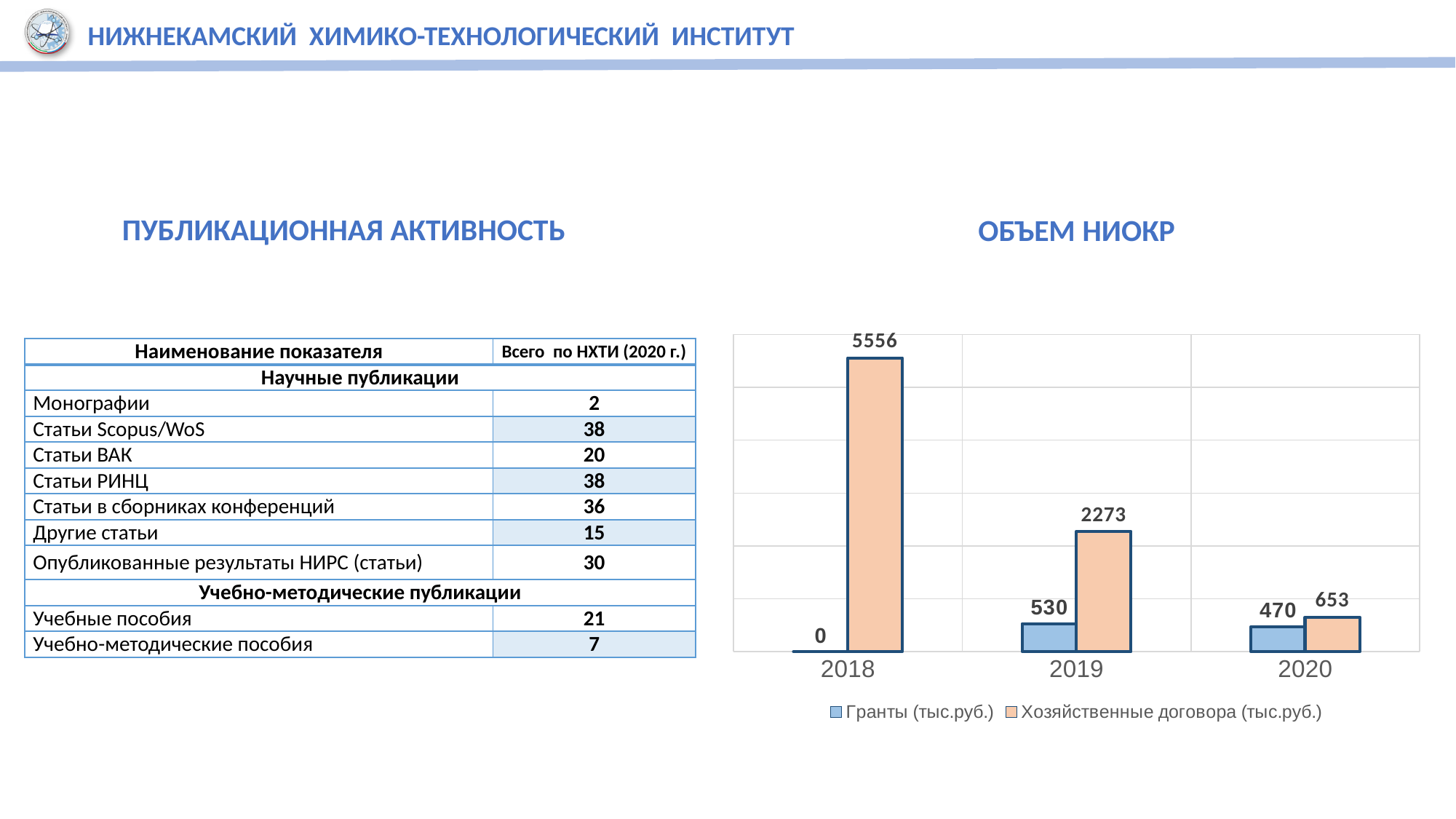
In which year is the value of Хозяйственные договора (тыс.руб.) highest? 2018 What type of chart is shown under the heading ОБЪЕМ НИОКР? bar chart How many years are shown on the x axis of the chart? 3 Which is larger in 2020: Гранты (тыс.руб.) or Хозяйственные договора (тыс.руб.)? Хозяйственные договора (тыс.руб.) How many series does the chart legend list? 2 What is the value of Хозяйственные договора (тыс.руб.) for 2018? 5556 What is the difference between Хозяйственные договора (тыс.руб.) in 2018 and 2019? 3283 What is the value of Хозяйственные договора (тыс.руб.) for 2020? 653 In which year is the value of Гранты (тыс.руб.) lowest? 2018 Does the value of Хозяйственные договора (тыс.руб.) rise or fall from 2018 to 2020? fall What is the value of Гранты (тыс.руб.) for 2019? 530 What is the value of Гранты (тыс.руб.) for 2018? 0